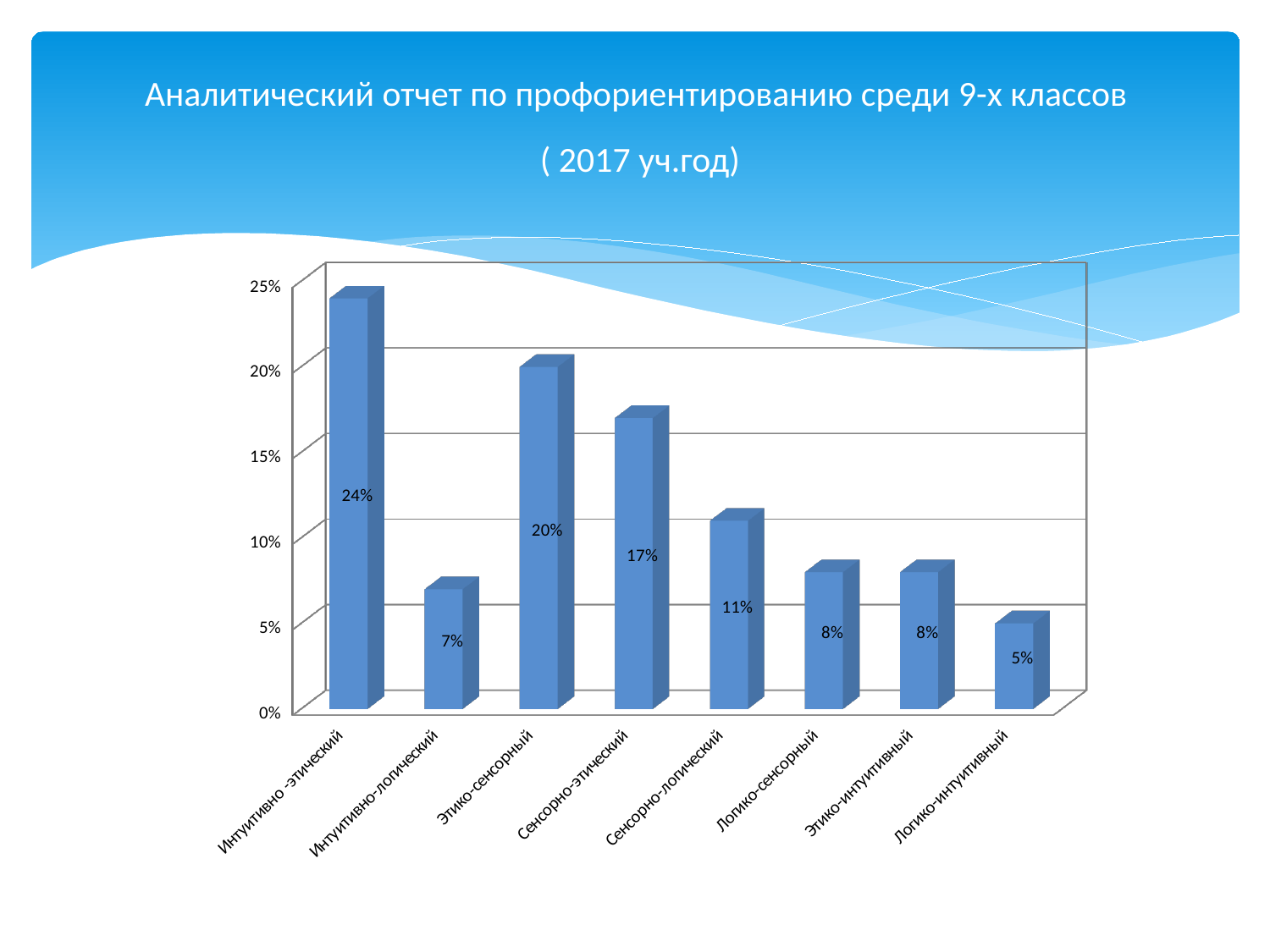
What is the value for Интуитивно-этический? 24% How many categories are shown in the chart? 8 What is the value for Этико-интуитивный? 8% What is the value for Сенсорно-логический? 11% What is the difference between Интуитивно-этический and Интуитивно-логический? 17% What is the value for Логико-интуитивный? 5% What kind of chart is shown on the slide? bar chart What is the difference between Этико-сенсорный and Сенсорно-этический? 3% Is the value for Этико-сенсорный greater or less than 15%? greater Which category has the lowest value? Логико-интуитивный Which category has the highest value? Интуитивно-этический Which is larger, Сенсорно-логический or Логико-сенсорный? Сенсорно-логический